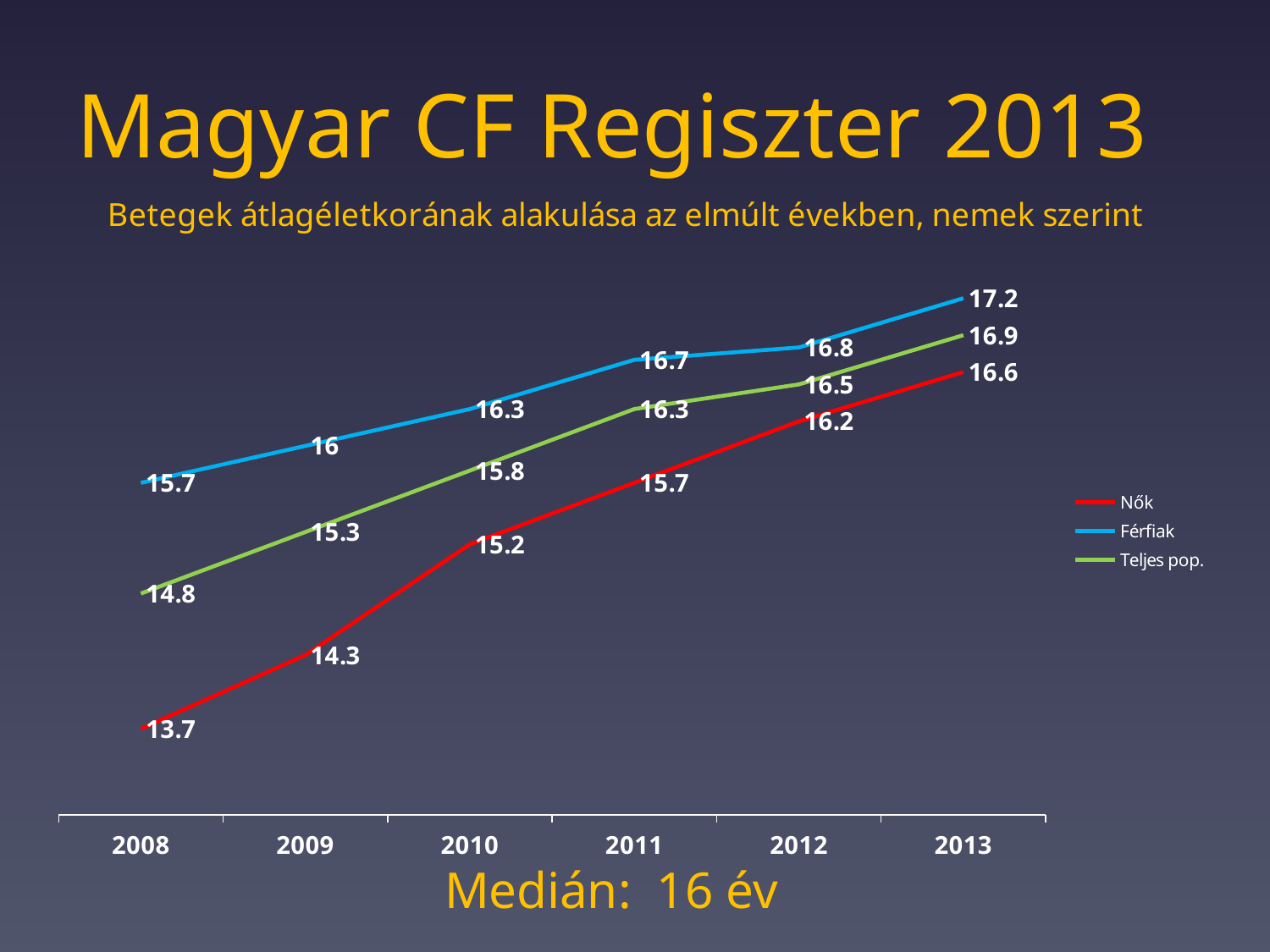
How many series does the legend list? 3 Which is larger in 2010: the Férfiak value or the Teljes pop. value? Férfiak In which year is the Nők series lowest? 2008 What kind of chart is shown on the slide? Line chart What is the value for Nők in 2008? 13.7 What is the value for Nők in 2012? 16.2 What is the value for Teljes pop. in 2011? 16.3 In which year is the Férfiak series highest? 2013 What is the difference between the Férfiak values in 2013 and 2008? 1.5 How many years are shown on the x axis? 6 What is the value for Férfiak in 2013? 17.2 What is the difference between the Férfiak and Nők values in 2008? 2